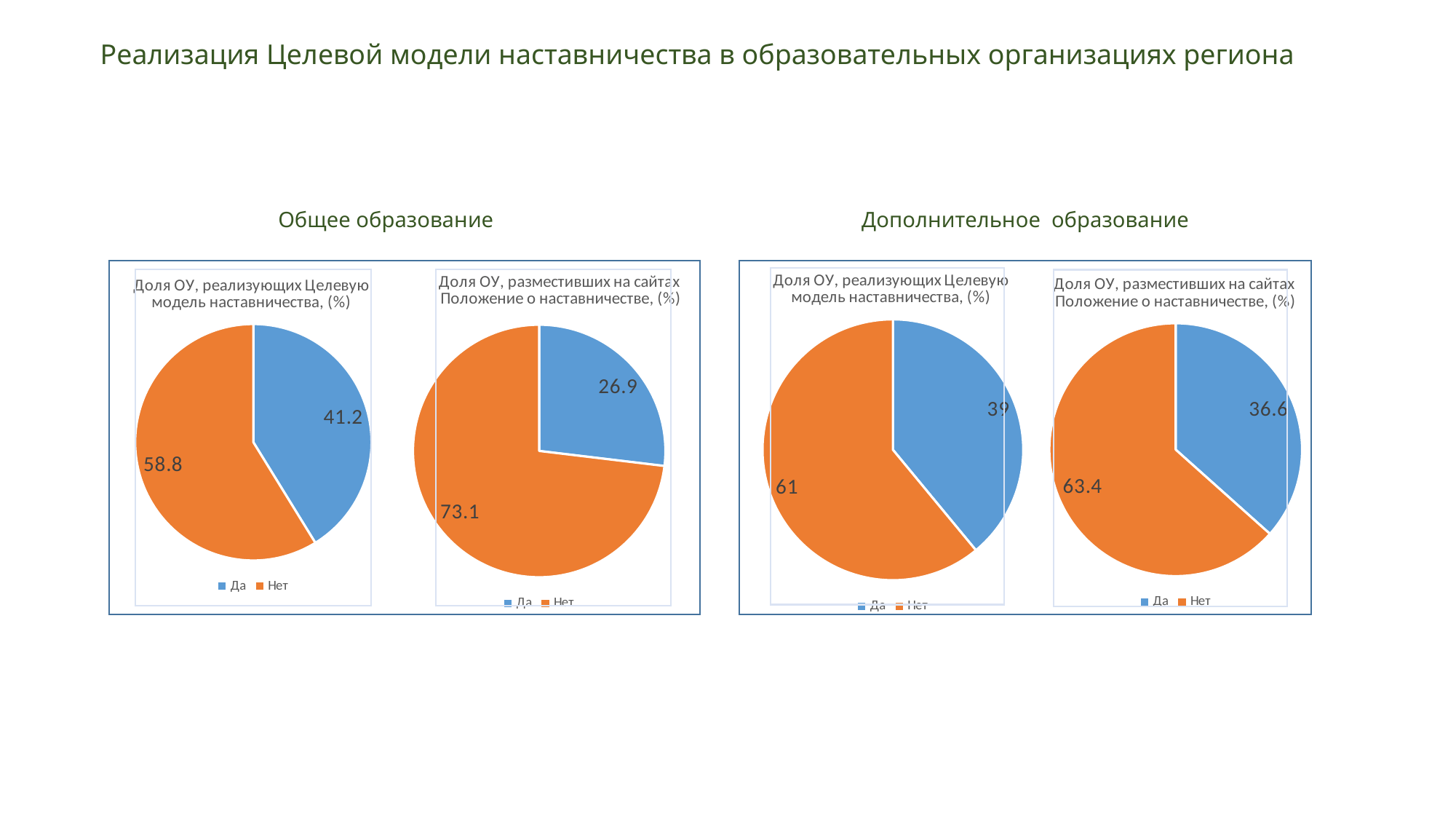
In the 'Дополнительное образование' chart 'Доля ОУ, разместивших на сайтах Положение о наставничестве, (%)', which slice is the largest? Нет What kind of chart is used for 'Доля ОУ, реализующих Целевую модель наставничества, (%)' under 'Общее образование'? Pie chart In the 'Дополнительное образование' chart 'Доля ОУ, реализующих Целевую модель наставничества, (%)', which is larger, 'Да' or 'Нет'? Нет In the 'Общее образование' chart 'Доля ОУ, разместивших на сайтах Положение о наставничестве, (%)', what is the value for 'Нет'? 73.1 In the 'Дополнительное образование' chart 'Доля ОУ, реализующих Целевую модель наставничества, (%)', what is the value for 'Да'? 39 In the 'Общее образование' chart 'Доля ОУ, реализующих Целевую модель наставничества, (%)', what is the difference between the 'Нет' and 'Да' values? 17.6 In the 'Общее образование' chart 'Доля ОУ, реализующих Целевую модель наставничества, (%)', what is the value for 'Да'? 41.2 In the 'Общее образование' chart 'Доля ОУ, разместивших на сайтах Положение о наставничестве, (%)', which slice is the smallest? Да In the 'Общее образование' chart 'Доля ОУ, реализующих Целевую модель наставничества, (%)', what is the value for 'Нет'? 58.8 In the 'Дополнительное образование' chart 'Доля ОУ, разместивших на сайтах Положение о наставничестве, (%)', what is the value for 'Нет'? 63.4 How many entries does the legend list in the 'Дополнительное образование' chart 'Доля ОУ, разместивших на сайтах Положение о наставничестве, (%)'? 2 In the 'Общее образование' chart 'Доля ОУ, разместивших на сайтах Положение о наставничестве, (%)', what is the value for 'Да'? 26.9